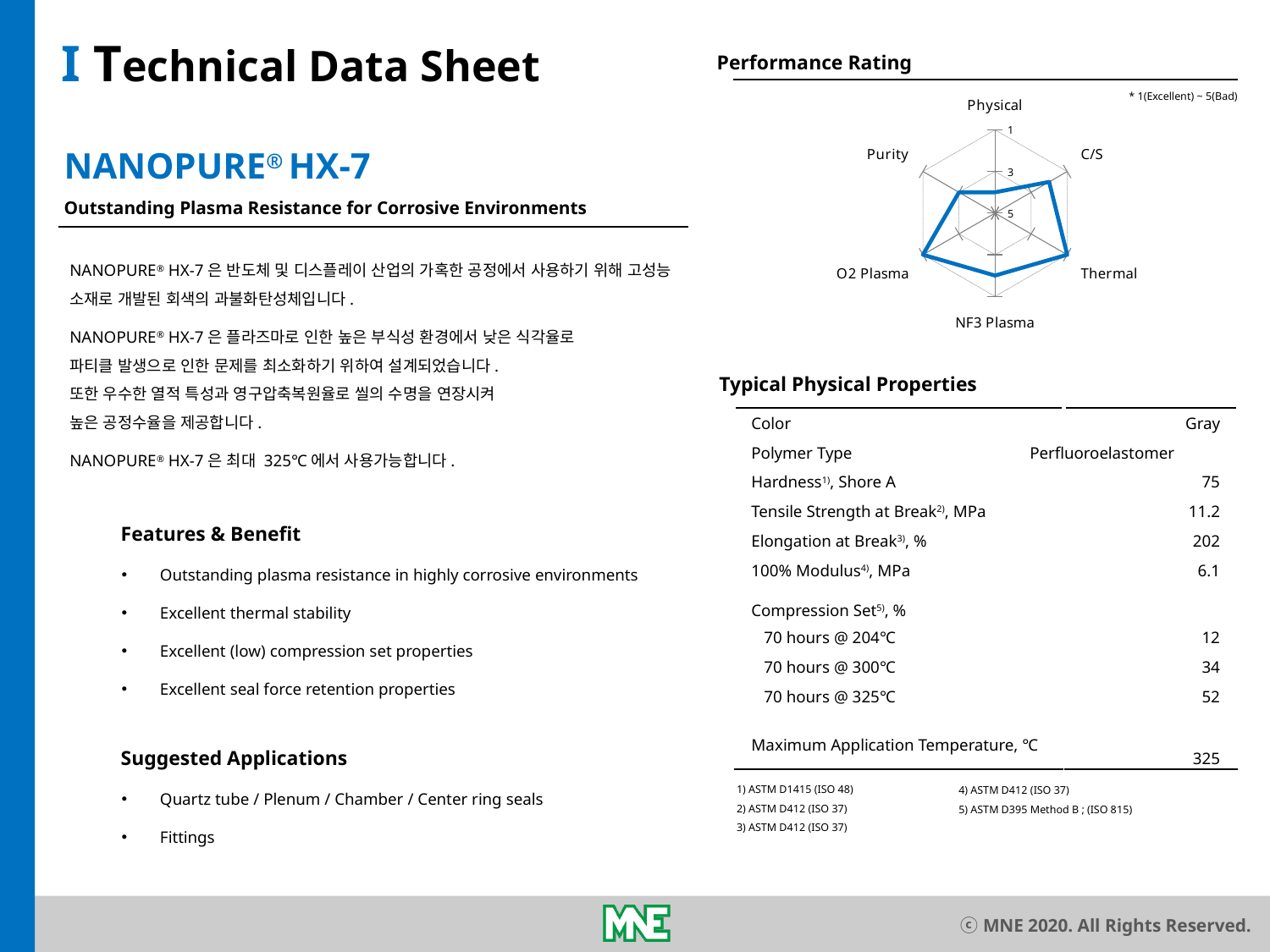
Which category label sits at the bottom of the Performance Rating radar chart? NF3 Plasma How many data series are plotted on the Performance Rating radar chart? 1 In the Performance Rating chart, is the value for O2 Plasma greater or less than 3? less In the Performance Rating chart, which has the larger rating value, Physical or Thermal? Physical What is the title of the chart on the slide? Performance Rating In the Performance Rating chart, which has the larger rating value, Purity or O2 Plasma? Purity In the Performance Rating chart, which category has the highest (worst) rating value, i.e. the point closest to the centre? Physical In the Performance Rating chart, is the value for Physical greater or less than 3? greater According to the note on the Performance Rating chart, what rating value means Excellent and what value means Bad? 1 (Excellent) ~ 5 (Bad) In the Performance Rating chart, is the value for Thermal greater or less than 3? less How many categories (axes) does the Performance Rating radar chart have? 6 What kind of chart is shown under the heading "Performance Rating"? Radar chart